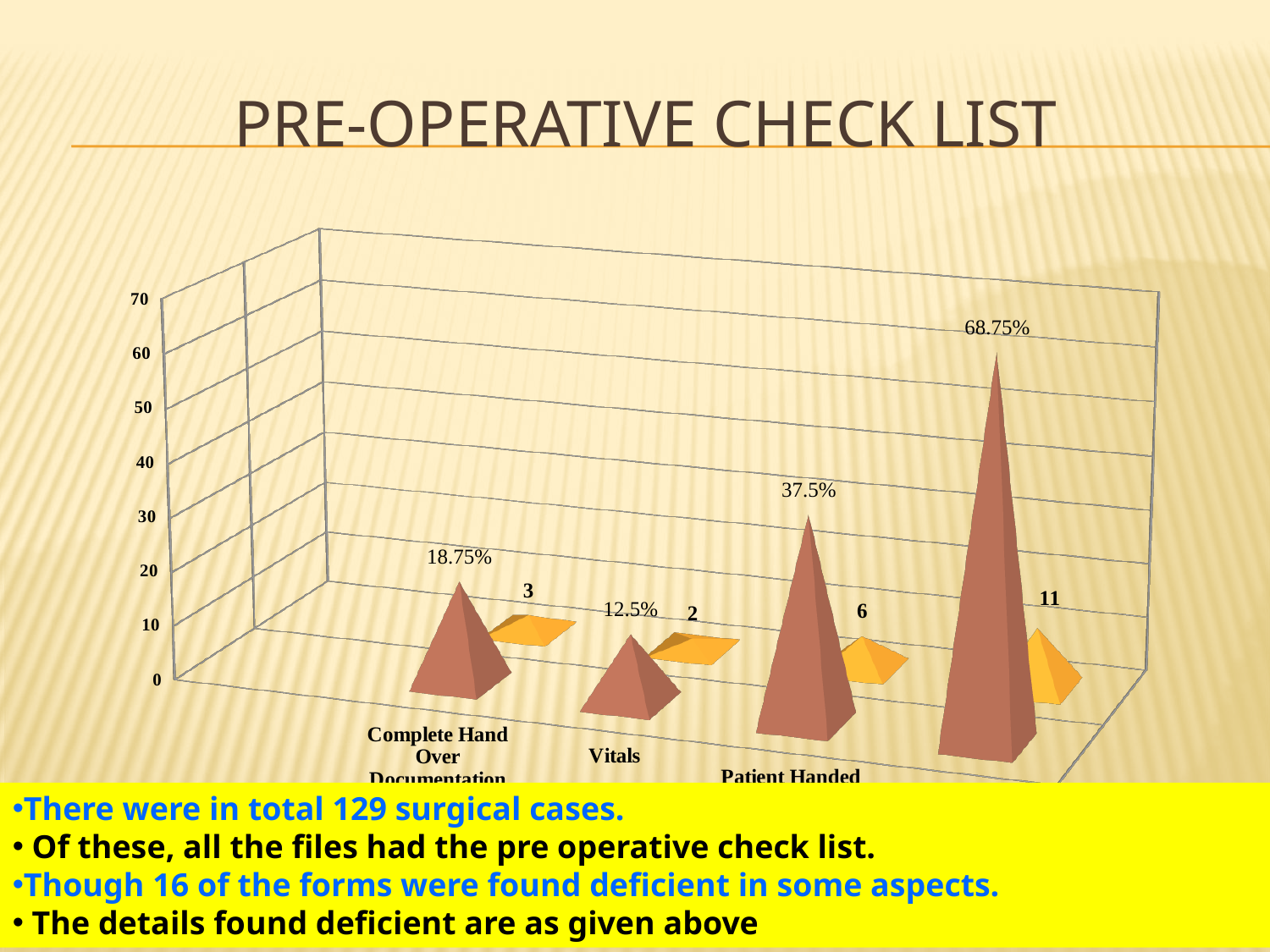
Which has a higher percentage, Vitals or Complete Hand Over Documentation? Complete Hand Over Documentation What is the highest percentage value labelled on the chart? 68.75% What kind of chart is shown on the slide? bar chart What count is shown for Complete Hand Over Documentation? 3 What percentage is shown for Complete Hand Over Documentation? 18.75% What count is shown for Vitals? 2 What is the title of the slide? PRE-OPERATIVE CHECK LIST What is the largest count value labelled on the chart? 11 What percentage is shown for Vitals? 12.5% How many categories are plotted on the chart? 4 What is the difference between the percentages for Complete Hand Over Documentation and Vitals? 6.25% Which category has the lowest percentage? Vitals